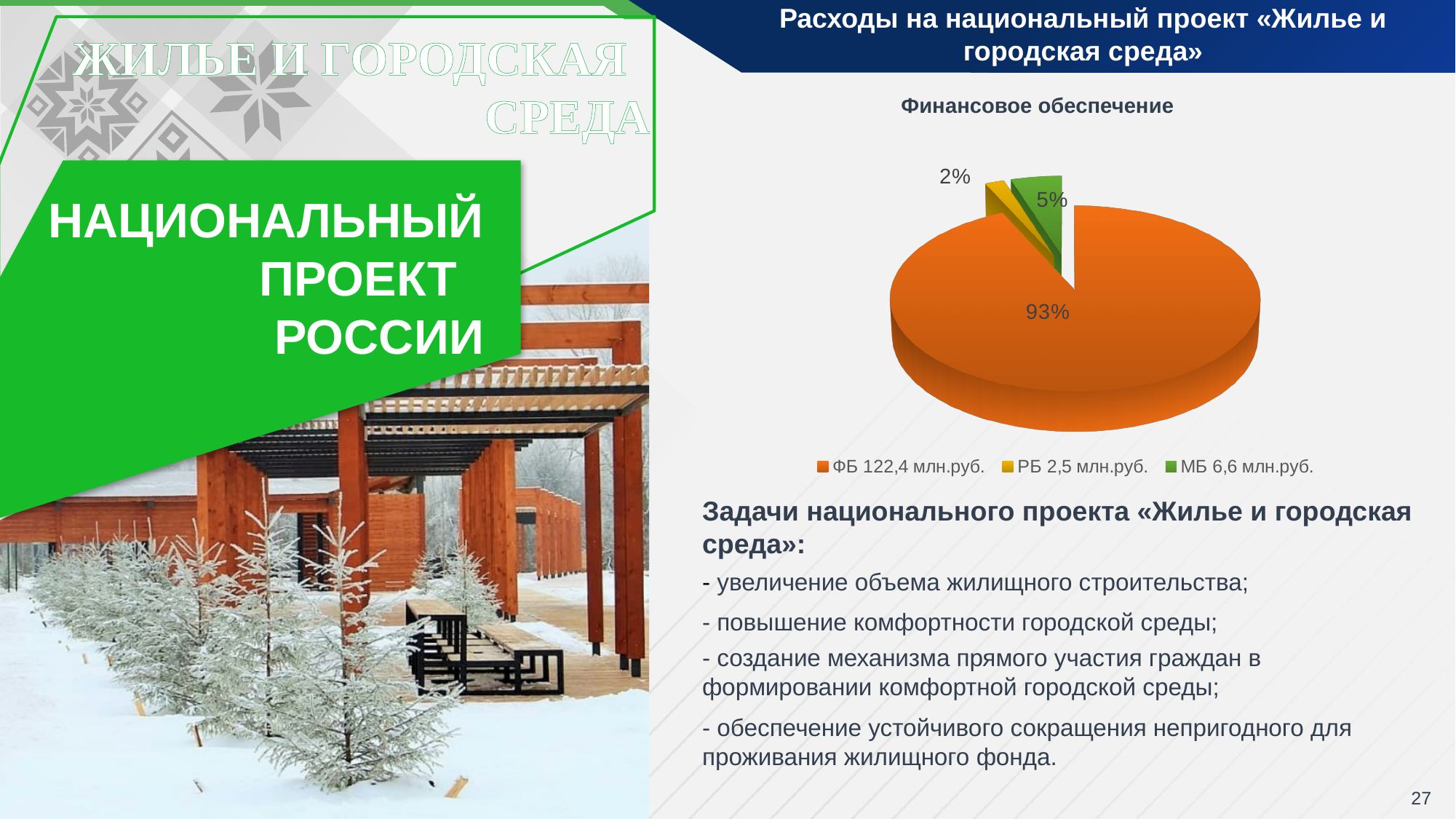
According to the legend, what amount in млн.руб. corresponds to МБ? 6,6 млн.руб. Which is larger in the pie chart: the МБ share or the РБ share? МБ What share of the pie does the ФБ slice represent? 93% According to the legend, what amount in млн.руб. corresponds to ФБ? 122,4 млн.руб. Which slice of the pie chart is the smallest? РБ 2,5 млн.руб. What kind of chart is shown under the heading «Финансовое обеспечение»? Pie chart What share of the pie does the РБ slice represent? 2% What is the title of the chart on the slide? Финансовое обеспечение How many entries does the legend of the pie chart list? 3 Which slice of the pie chart is the largest? ФБ 122,4 млн.руб. How many slices does the pie chart have? 3 What share of the pie does the МБ slice represent? 5%